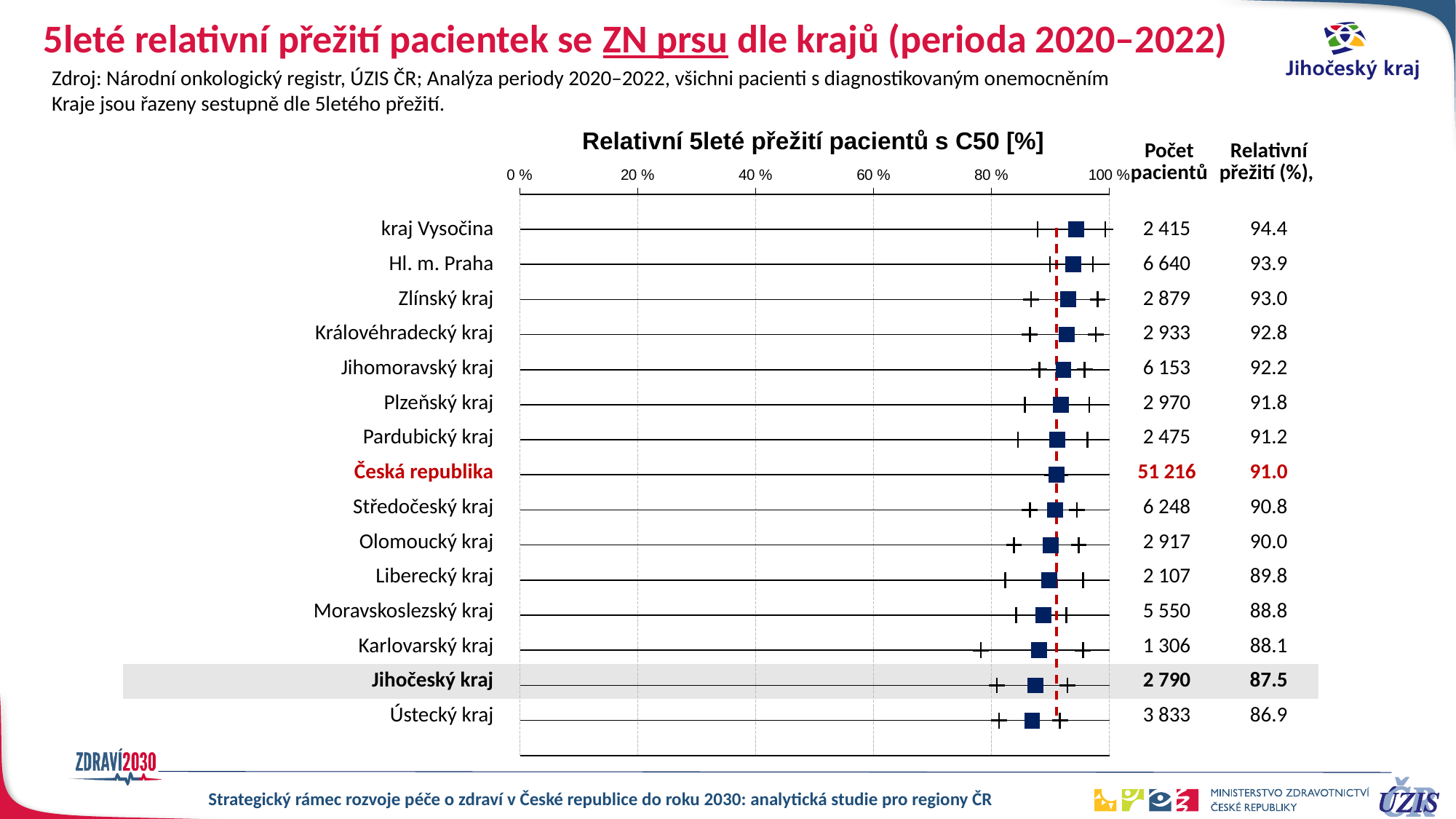
How many patients (Počet pacientů) are listed for Hl. m. Praha? 6 640 Which has a higher relative 5-year survival, Zlínský kraj or Olomoucký kraj? Zlínský kraj How many rows (regions including Česká republika) are plotted in the chart? 15 What is the relative 5-year survival (%) for kraj Vysočina? 94.4 Do the relative survival values rise or fall going down the list from kraj Vysočina to Ústecký kraj? fall Is the relative 5-year survival for Karlovarský kraj greater or less than 80 %? greater What is the title of the chart? Relativní 5leté přežití pacientů s C50 [%] How many patients (Počet pacientů) are listed for Česká republika? 51 216 What is the relative 5-year survival (%) for Jihočeský kraj? 87.5 What is the difference in relative 5-year survival (%) between kraj Vysočina and Ústecký kraj? 7.5 Which region has the highest relative 5-year survival? kraj Vysočina Which region has the lowest relative 5-year survival? Ústecký kraj